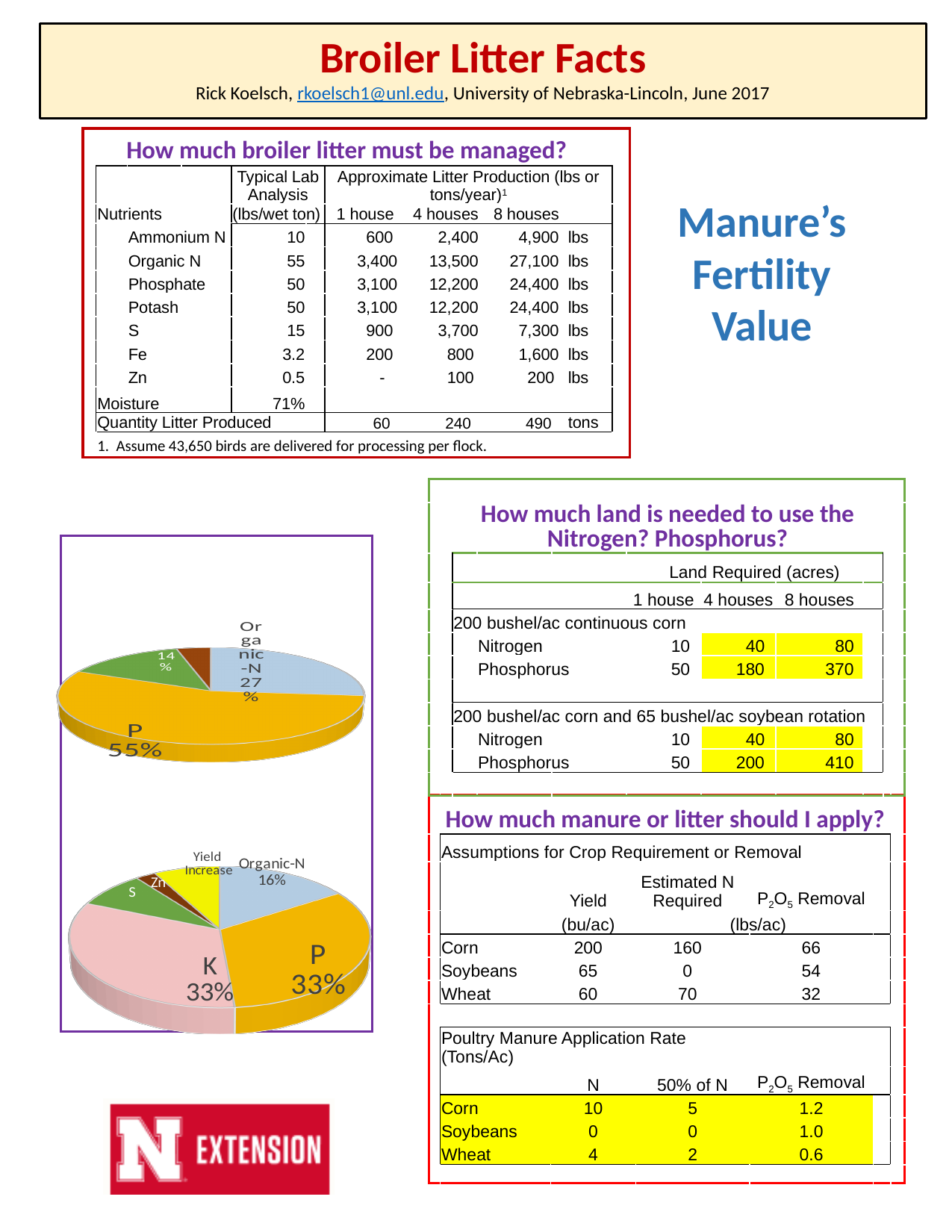
In the bottom pie chart on the left, what share is labelled for K? 33% In the bottom pie chart on the left, how many percentage points larger is the P slice than the Organic-N slice? 17 percentage points In the bottom pie chart on the left, which slice is larger, Organic-N or P? P In the bottom pie chart on the left, what share is labelled for P? 33% How many slices does the bottom pie chart on the left have? 6 In the top pie chart on the left, how many percentage points larger is the P slice than the Organic-N slice? 28 percentage points In the top pie chart on the left, which labelled slice is the largest? P How many slices does the top pie chart on the left have? 4 What kind of chart is the top chart on the left side of the slide? Pie chart In the top pie chart on the left, what share is labelled for Organic-N? 27% In the top pie chart on the left, what share is labelled for P? 55% In the bottom pie chart on the left, what share is labelled for Organic-N? 16%